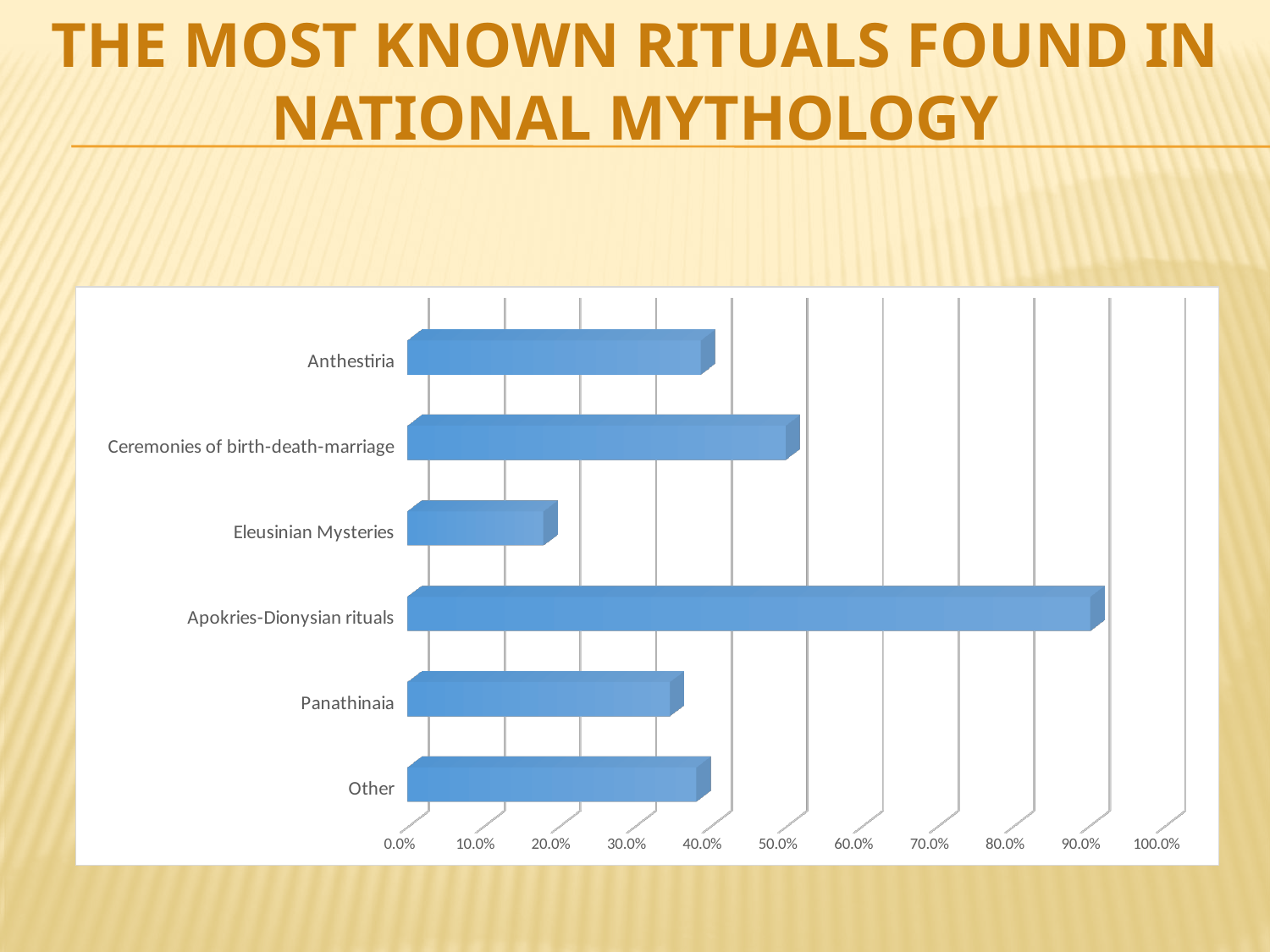
Is the value for Panathinaia greater or less than 40.0%? less Which has the larger value, Ceremonies of birth-death-marriage or Anthestiria? Ceremonies of birth-death-marriage Which ritual has the highest value in the chart? Apokries-Dionysian rituals What is the title of the slide containing the chart? The Most Known Rituals Found in National Mythology Is the value for Eleusinian Mysteries greater or less than 10.0%? greater Which has the larger value, Panathinaia or Eleusinian Mysteries? Panathinaia Is the value for Eleusinian Mysteries greater or less than 20.0%? less Which ritual has the lowest value in the chart? Eleusinian Mysteries What kind of chart is shown on the slide? bar chart How many rituals (categories) are plotted in the chart? 6